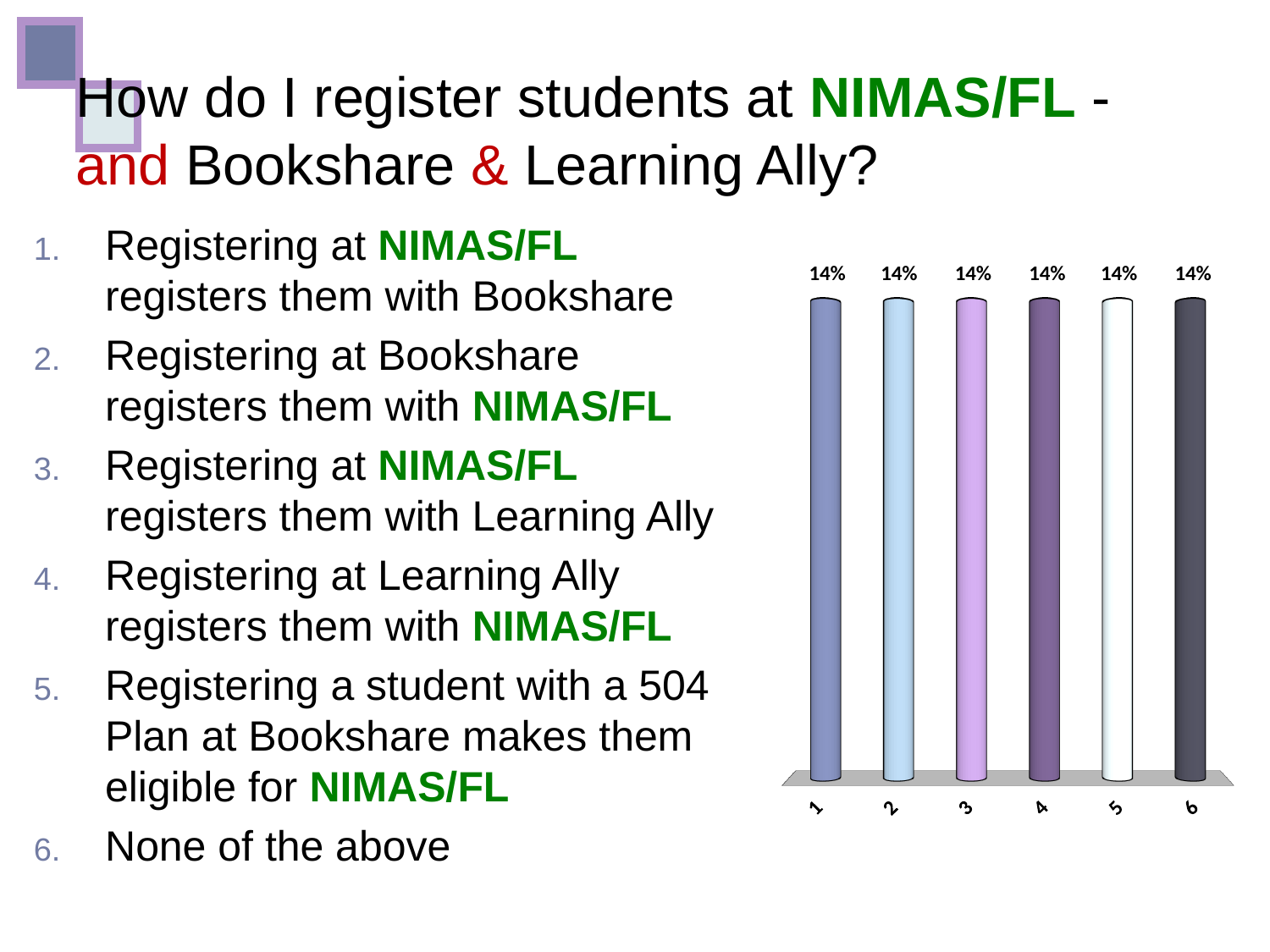
How many bars are plotted in the chart? 6 What type of chart is shown on the slide? bar chart What are the category labels along the x axis? 1, 2, 3, 4, 5, 6 Are all six bars labeled with the same value? yes What is the difference between the values for category 2 and category 4? 0% What is the value shown for category 3? 14% Do the values rise, fall, or stay flat across categories 1 to 6? stay flat Which category's bar is white? 5 What is the value shown for category 5? 14% What is the value shown for category 1? 14% What is the value shown for category 6? 14%